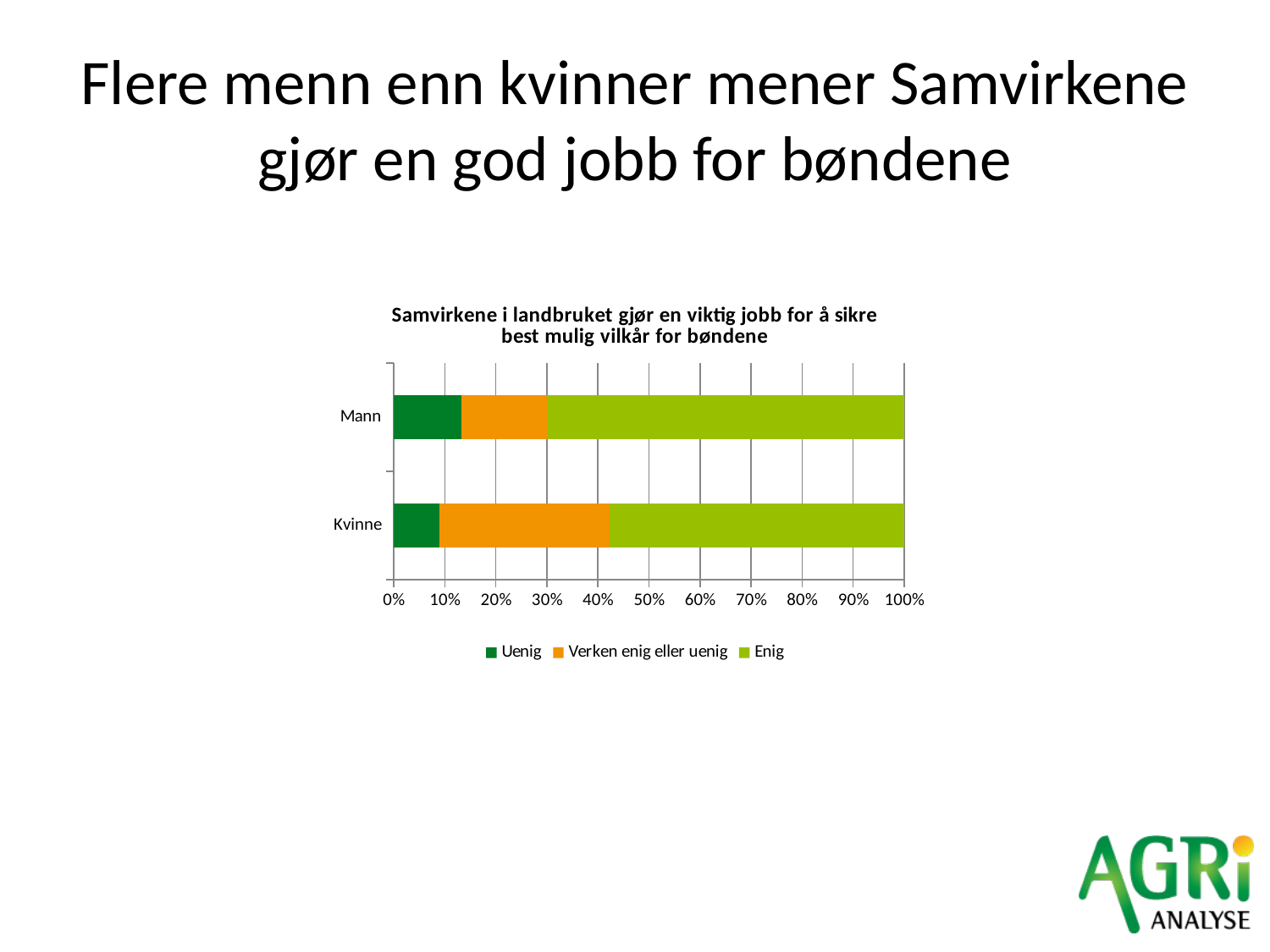
Which category has the larger Enig share, Mann or Kvinne? Mann Is the Enig share for Kvinne greater or less than 50%? greater Is the Enig share for Mann greater or less than 60%? greater Which series is shown in orange in the chart? Verken enig eller uenig What kind of chart is shown on the slide? bar chart Which category has the larger Verken enig eller uenig share, Mann or Kvinne? Kvinne Is the Verken enig eller uenig share for Kvinne greater or less than 20%? greater How many series does the legend list? 3 What is the title of the chart? Samvirkene i landbruket gjør en viktig jobb for å sikre best mulig vilkår for bøndene Which category has the larger Uenig share, Mann or Kvinne? Mann How many categories are shown on the chart? 2